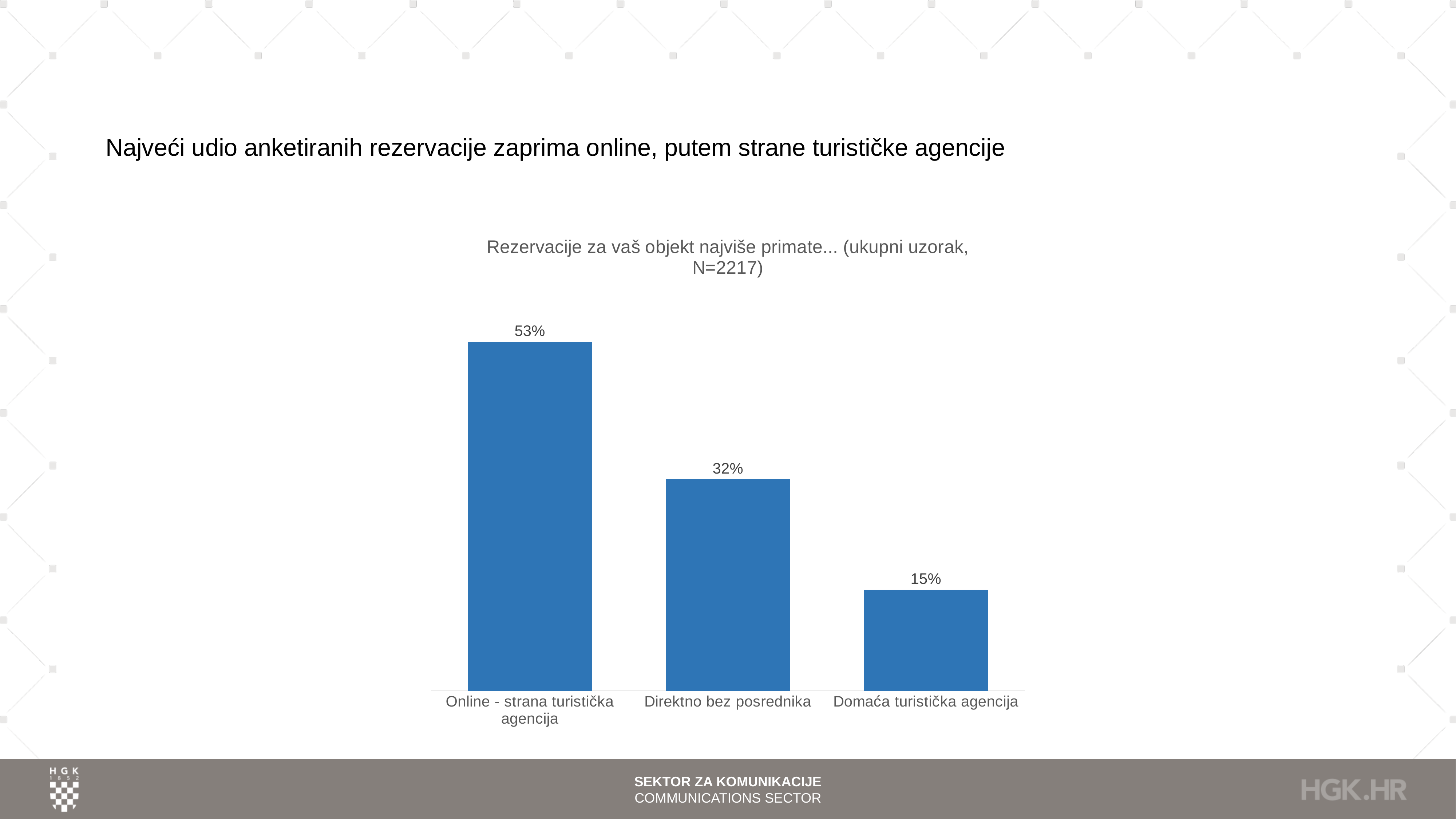
Which category has the highest value? Online - strana turistička agencija What sample size (N) is stated in the chart title? N=2217 What is the difference between the values for "Online - strana turistička agencija" and "Direktno bez posrednika"? 21% What is the value for "Domaća turistička agencija"? 15% What kind of chart is shown on the slide? Bar chart Which is larger, the value for "Direktno bez posrednika" or for "Domaća turistička agencija"? Direktno bez posrednika What is the value for "Direktno bez posrednika"? 32% What is the value for "Online - strana turistička agencija"? 53% Which category has the lowest value? Domaća turistička agencija Do the values rise or fall from left to right along the x axis? Fall How many categories are shown in the chart? 3 What is the difference between the values for "Direktno bez posrednika" and "Domaća turistička agencija"? 17%